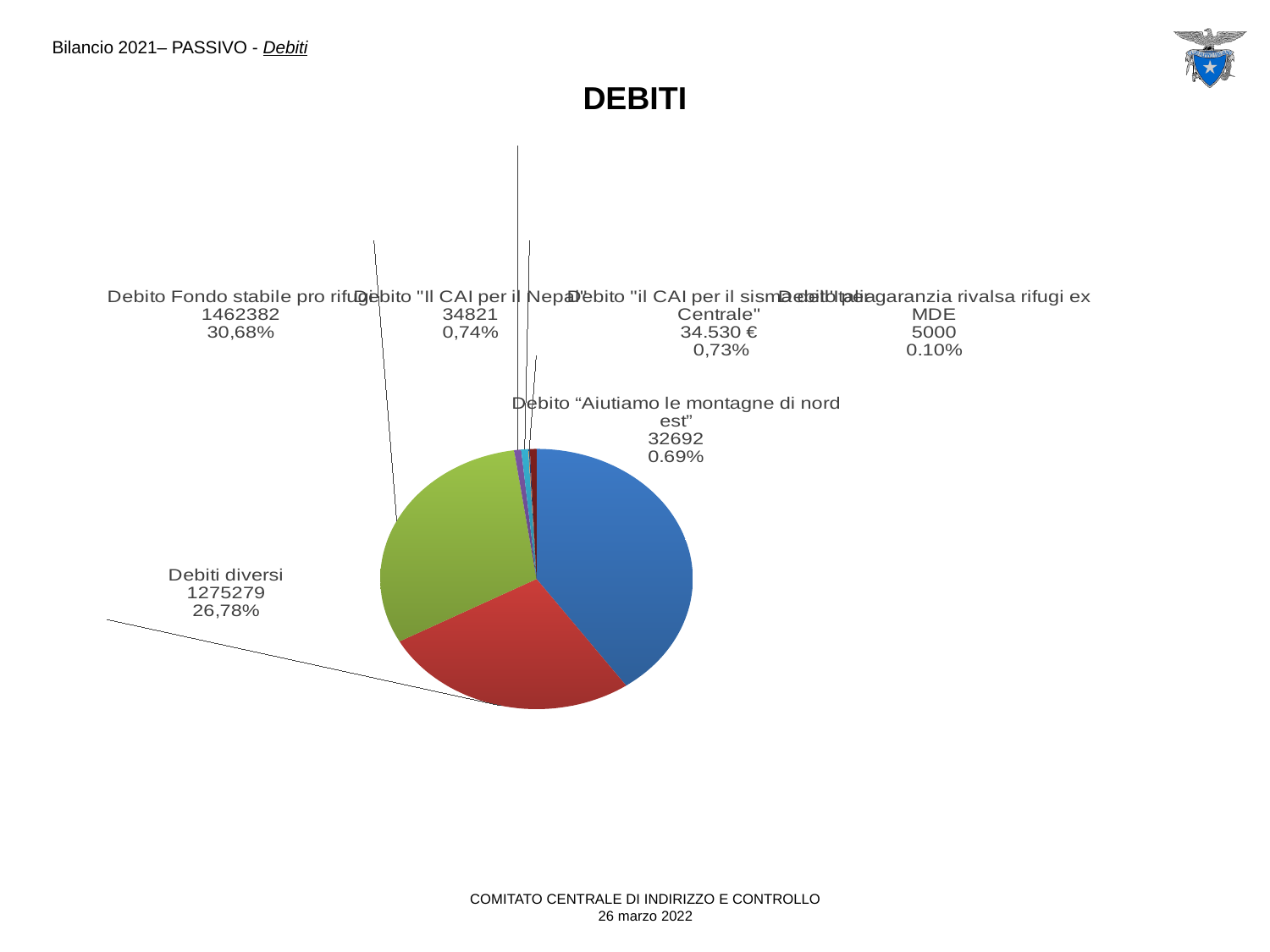
What share of the pie does Debiti diversi represent? 26,78% What is the difference between the values for Debito Fondo stabile pro rifugi and Debiti diversi? 187103 What is the value shown for Debiti diversi? 1275279 Which labelled category has the smallest value? Debito per garanzia rivalsa rifugi ex MDE Which is larger, Debito Fondo stabile pro rifugi or Debiti diversi? Debito Fondo stabile pro rifugi What kind of chart is shown on the slide? pie chart What percentage is shown for Debito "Aiutiamo le montagne di nord est"? 0.69% What is the value shown for Debito Fondo stabile pro rifugi? 1462382 What is the value shown for Debito "Il CAI per il Nepal"? 34821 What is the value shown for Debito "Aiutiamo le montagne di nord est"? 32692 What is the title of the chart? DEBITI What percentage is shown for Debito Fondo stabile pro rifugi? 30,68%